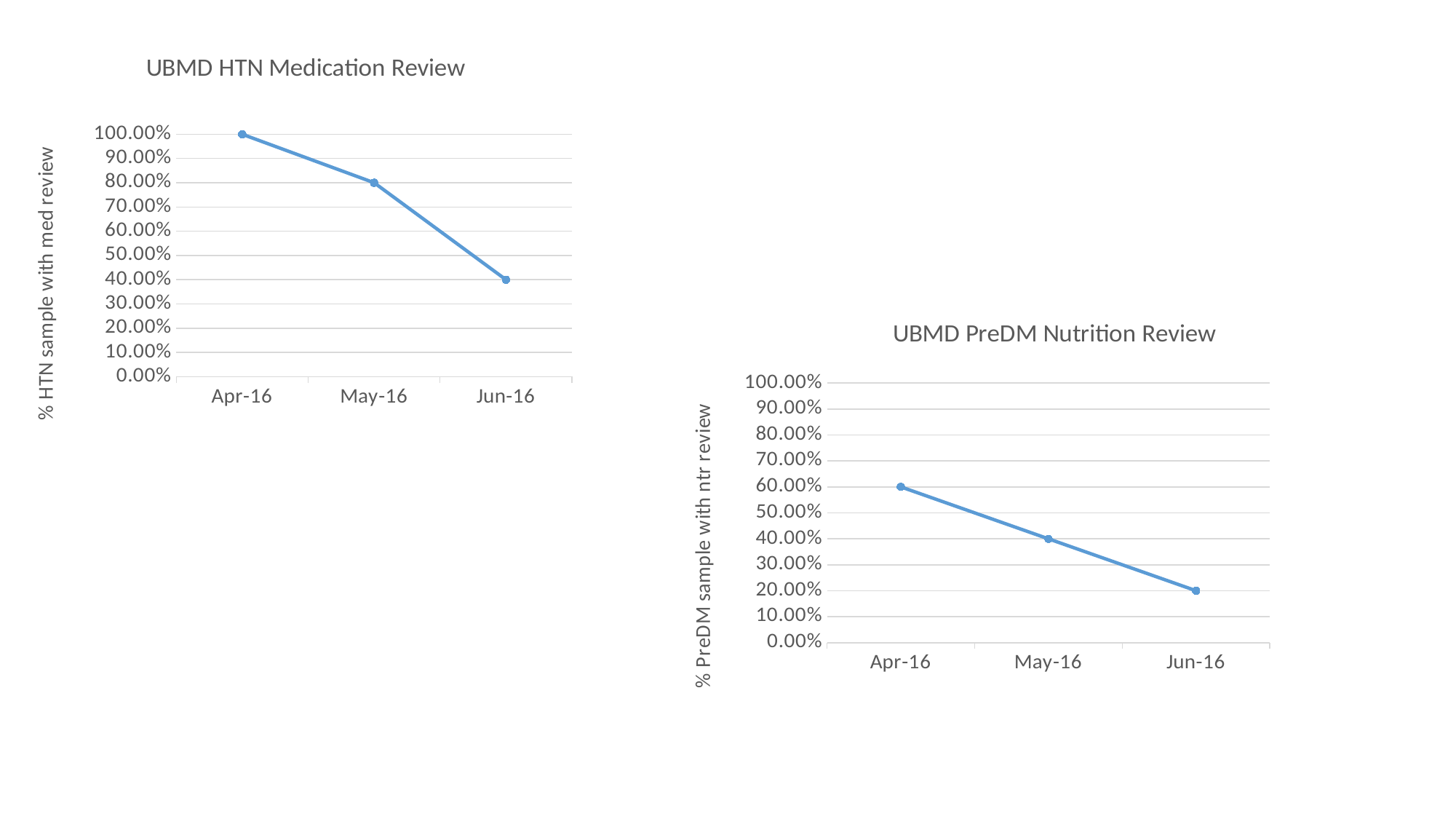
In the UBMD HTN Medication Review chart, what is the difference between the Apr-16 and May-16 values? 20.00% How many data points are plotted in the UBMD HTN Medication Review chart? 3 In the UBMD HTN Medication Review chart, which month has the lowest value? Jun-16 What kind of chart is the UBMD PreDM Nutrition Review chart? line chart In the UBMD PreDM Nutrition Review chart, what is the value for Jun-16? 20.00% In the UBMD HTN Medication Review chart, what is the value for Jun-16? 40.00% In the UBMD HTN Medication Review chart, is the value for May-16 greater or less than 50.00%? greater In the UBMD PreDM Nutrition Review chart, what is the difference between the Apr-16 and Jun-16 values? 40.00% In the UBMD PreDM Nutrition Review chart, what is the value for May-16? 40.00% In the UBMD PreDM Nutrition Review chart, which month has the highest value? Apr-16 In the UBMD PreDM Nutrition Review chart, do the values rise or fall from Apr-16 to Jun-16? fall In the UBMD HTN Medication Review chart, what is the value for Apr-16? 100.00%